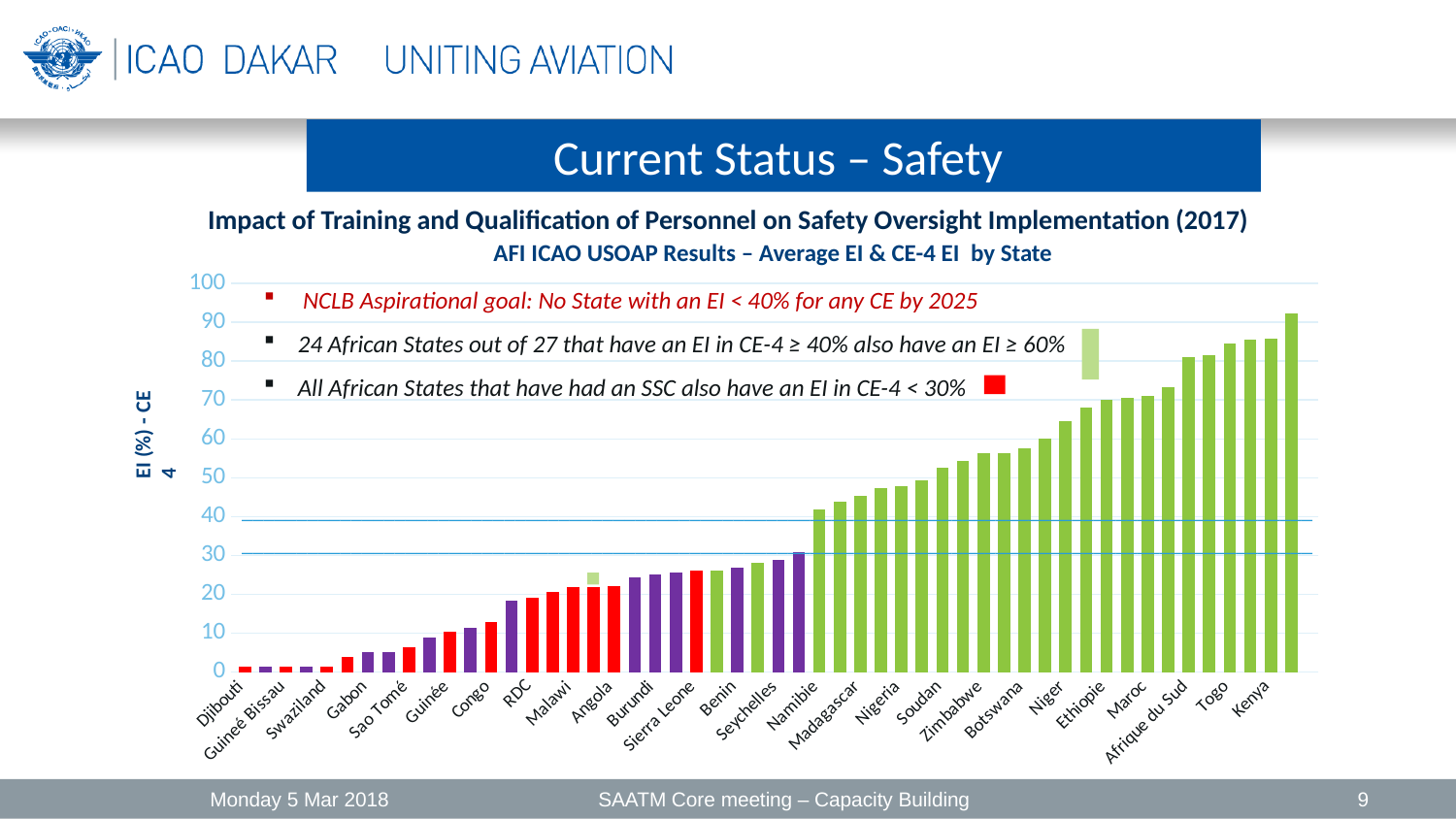
What kind of chart is shown on the slide? bar chart Is the value for Niger greater or less than 60? greater Is the value for Togo greater or less than 80? greater Which has a higher value, Togo or Benin? Togo Is the value for Botswana greater or less than 60? less Do the values rise or fall moving from left to right along the x axis? rise What is the label on the vertical axis of the chart? EI (%) - CE 4